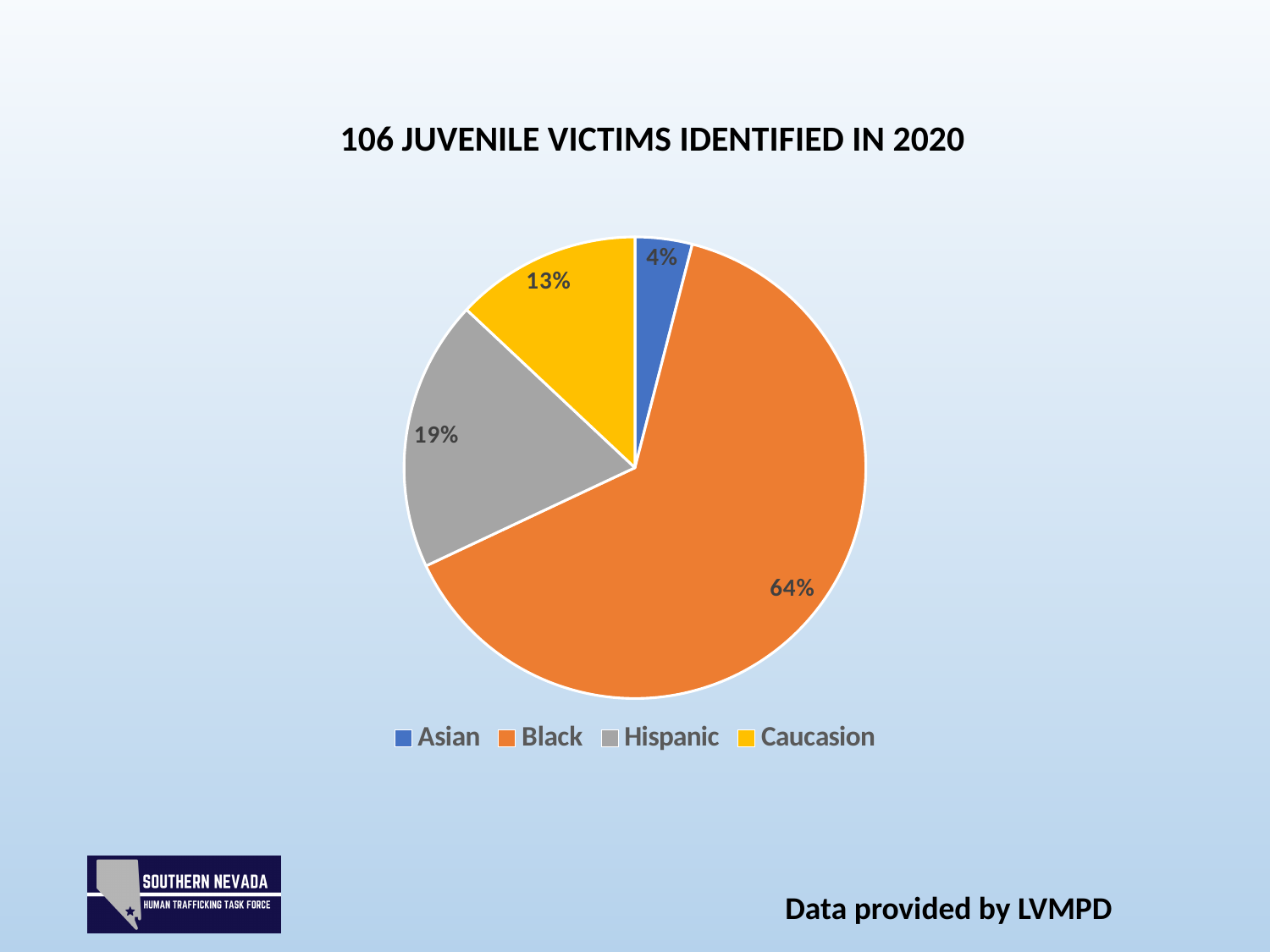
How many categories does the pie chart show? 4 What kind of chart is shown on the slide? pie chart What percentage of the pie is the Caucasion slice? 13% What percentage of the pie is the Asian slice? 4% Which colour represents the Caucasion category in the legend? yellow Which slice is larger, Hispanic or Caucasion? Hispanic What is the title of the chart? 106 JUVENILE VICTIMS IDENTIFIED IN 2020 Which category has the largest slice of the pie? Black What is the difference in percentage points between the Black and Hispanic slices? 45 Which category has the smallest slice of the pie? Asian What percentage of the pie is the Hispanic slice? 19% What percentage of the pie is the Black slice? 64%